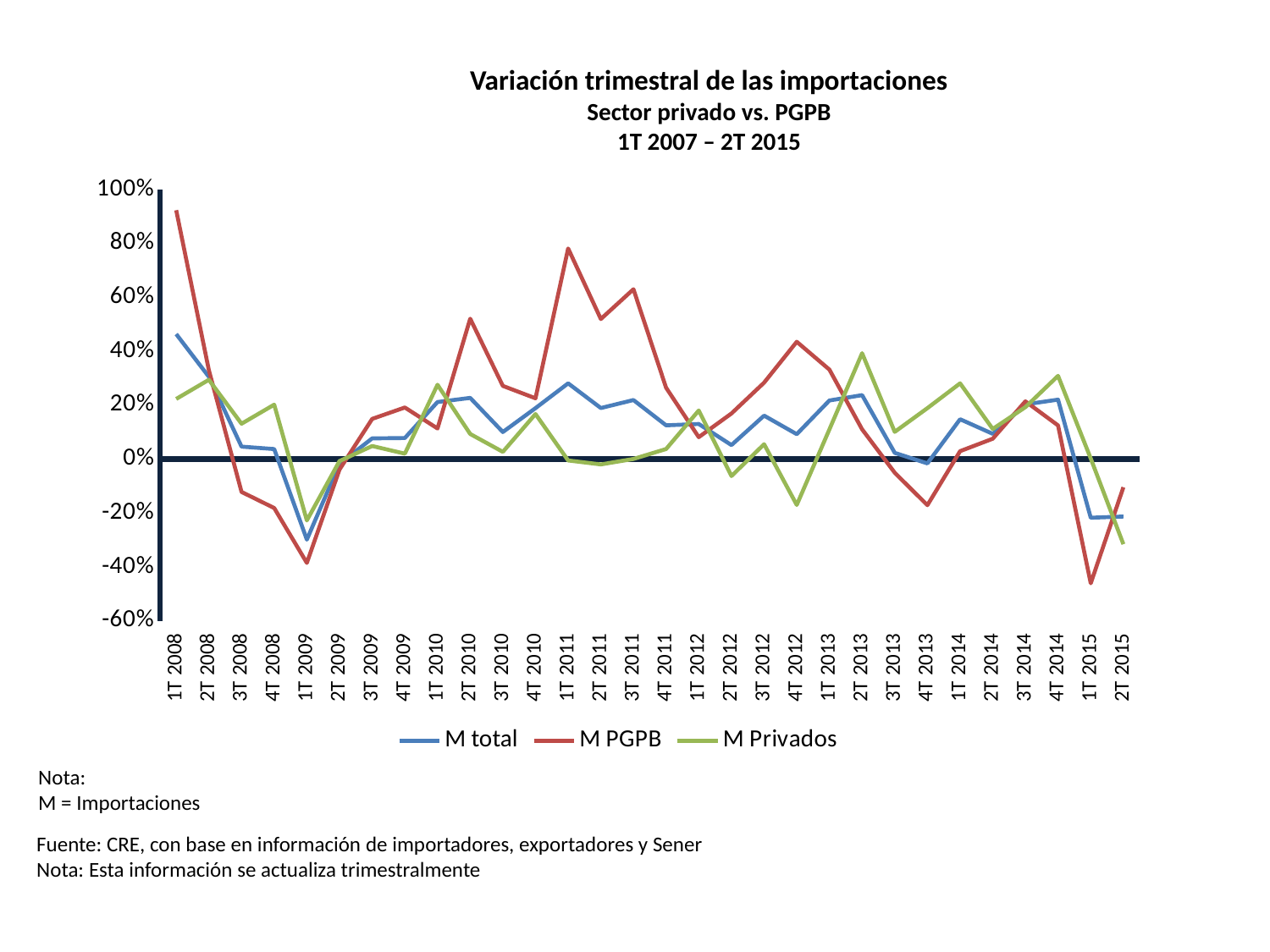
How many quarters are plotted along the x axis? 30 What kind of chart is shown on the slide? line chart In which quarter does M PGPB reach its lowest value? 1T 2015 Does M PGPB rise or fall from 1T 2008 to 1T 2009? fall Which series is drawn in red? M PGPB Is the value for M PGPB in 1T 2011 greater or less than 60%? greater Is the value for M PGPB in 1T 2008 greater or less than 80%? greater Is the value for M PGPB in 1T 2015 greater or less than -40%? less How many series does the legend list? 3 In which quarter does M PGPB reach its highest value? 1T 2008 In which quarter does M total reach its lowest value? 1T 2009 In 4T 2012, which is larger: M PGPB or M Privados? M PGPB